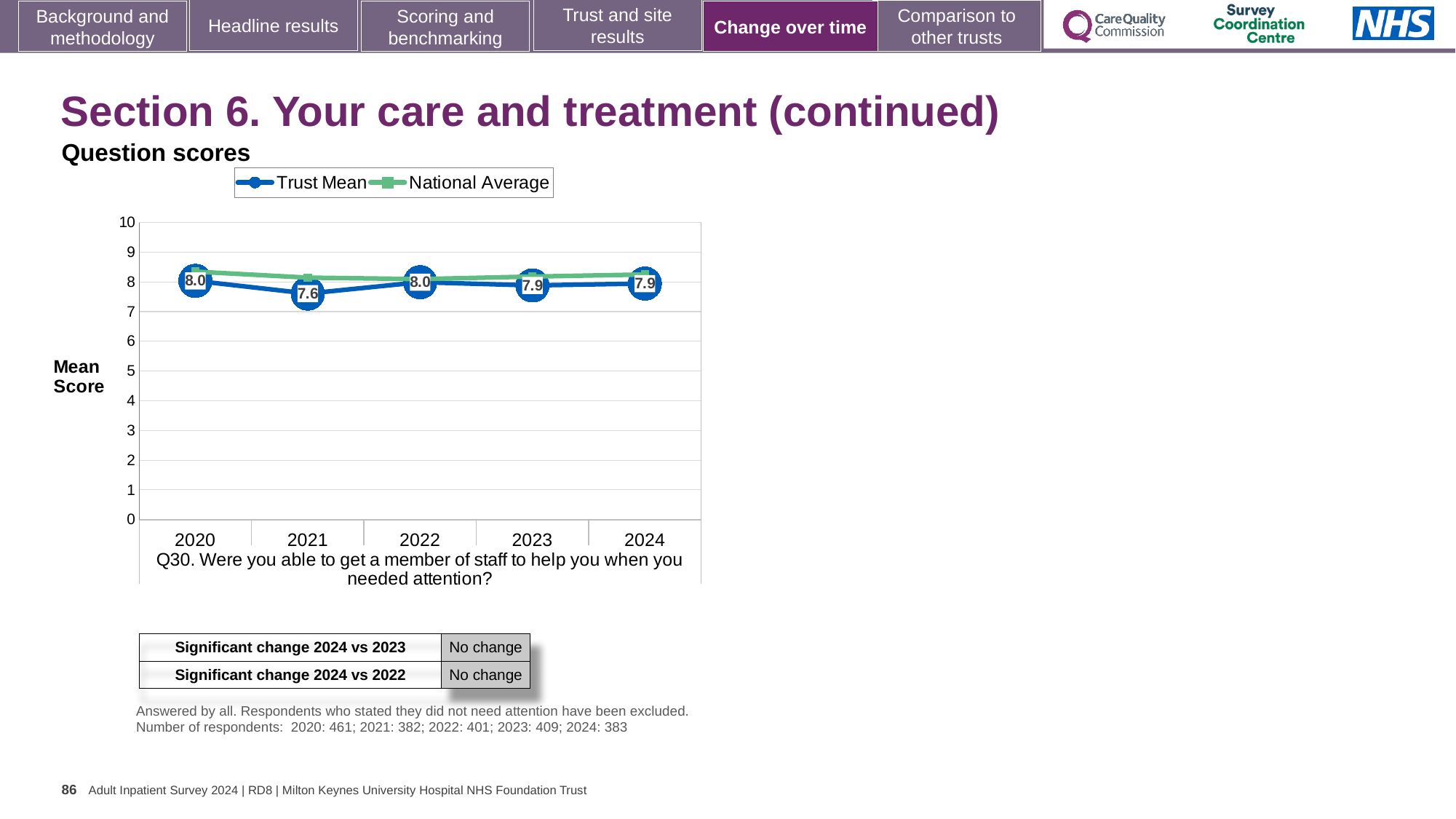
Is the National Average value for 2021 greater or less than 7? greater What is the Trust Mean score for 2020? 8.0 How many series does the chart legend list? 2 What is the Trust Mean score for 2024? 7.9 How many years are shown on the x axis of the chart? 5 What kind of chart is shown on the slide? Line chart What is the Trust Mean score for 2021? 7.6 Which is larger, the Trust Mean score for 2021 or for 2023? 2023 What is the label on the y axis of the chart? Mean Score In which year is the Trust Mean score lowest? 2021 What is the difference between the Trust Mean scores for 2022 and 2021? 0.4 Does the Trust Mean score rise or fall from 2020 to 2021? Fall